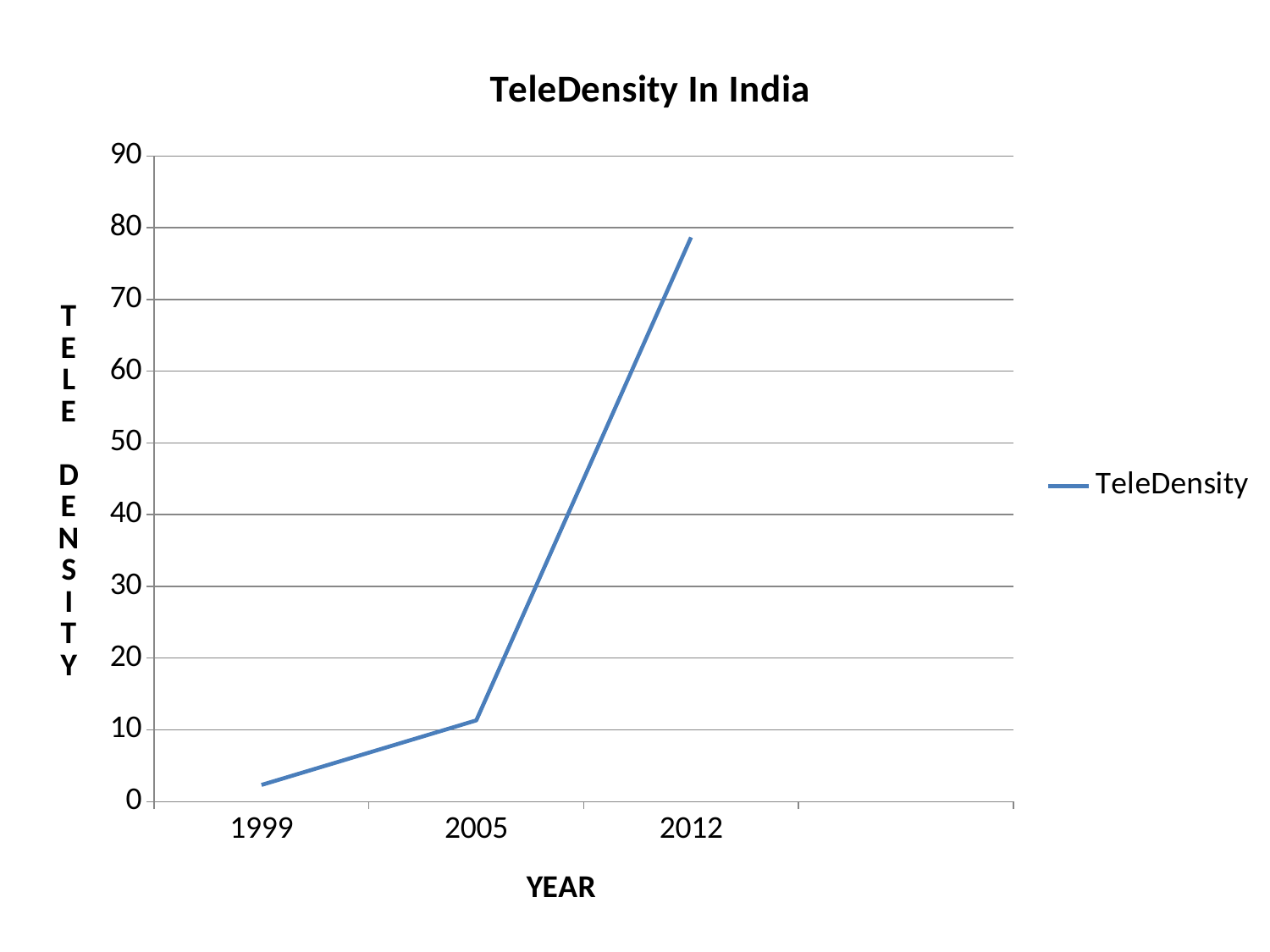
What kind of chart is shown on the slide? line chart Which year has a larger TeleDensity value, 2005 or 2012? 2012 Which year has the lowest TeleDensity value? 1999 How many years are plotted on the x axis? 3 Is the TeleDensity value for 2005 greater or less than 20? less Is the TeleDensity value for 2012 greater or less than 70? greater Which year has the highest TeleDensity value? 2012 What is the title of the chart? TeleDensity In India Is the TeleDensity value for 1999 greater or less than 10? less Do the TeleDensity values rise or fall from 1999 to 2012? rise How many series does the legend list? 1 What is the label of the x axis? YEAR